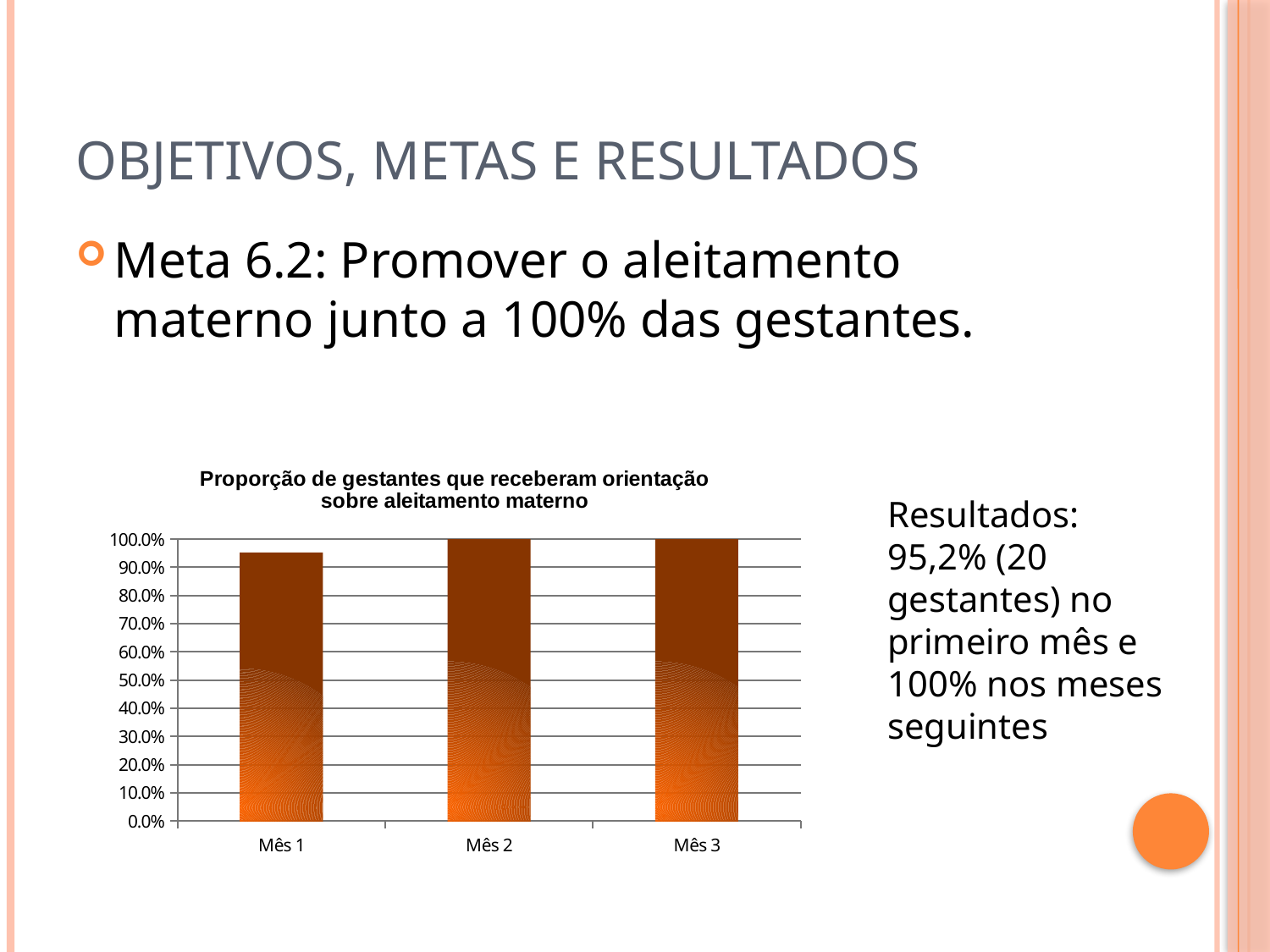
Is the value for Mês 1 greater or less than 100.0%? less Do the values rise or fall from Mês 1 to Mês 2? rise What is the value for Mês 2 in the chart? 100.0% Is the value for Mês 1 greater or less than 90.0%? greater What kind of chart is shown on the slide? bar chart What is the highest tick value shown on the y axis of the chart? 100.0% How many categories (months) are shown on the x axis of the chart? 3 Which month has the lowest value in the chart? Mês 1 What is the value for Mês 3 in the chart? 100.0% What is the title of the chart? Proporção de gestantes que receberam orientação sobre aleitamento materno Which is larger, the value for Mês 1 or the value for Mês 2? Mês 2